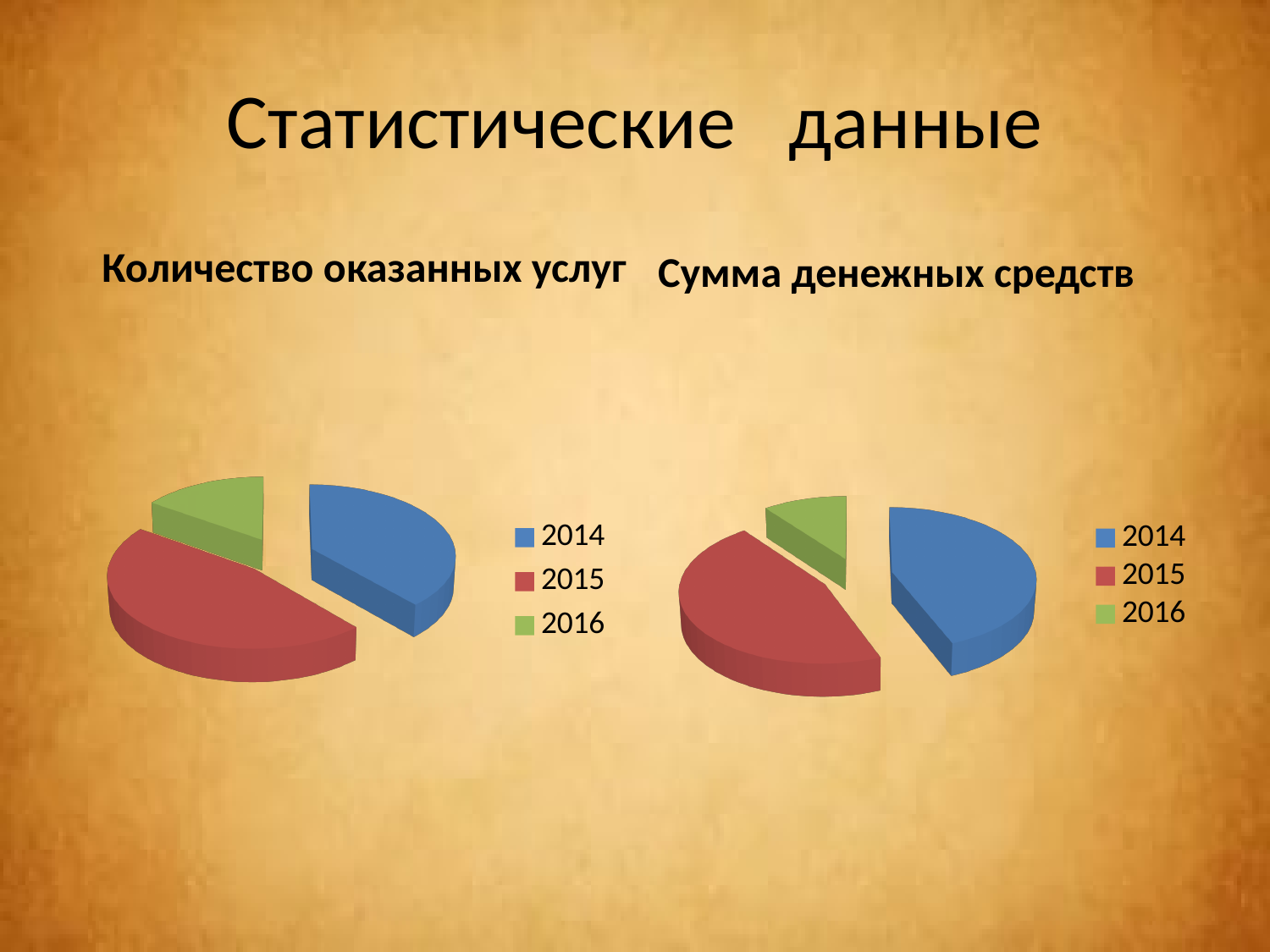
What kind of chart is the "Количество оказанных услуг" chart? pie chart What is the title of the chart on the left of the slide? Количество оказанных услуг In the "Сумма денежных средств" chart, which year has the largest slice? 2015 In the "Количество оказанных услуг" chart, which slice is larger, 2015 or 2016? 2015 In the "Сумма денежных средств" chart, which slice is larger, 2014 or 2016? 2014 In the "Количество оказанных услуг" chart, which year has the largest slice? 2015 In the "Количество оказанных услуг" chart, which year has the smallest slice? 2016 In the "Количество оказанных услуг" chart, how many slices does the pie have? 3 In the "Сумма денежных средств" chart, what colour represents 2015 in the legend? red In the "Сумма денежных средств" chart, how many entries does the legend list? 3 In the "Сумма денежных средств" chart, which year has the smallest slice? 2016 What kind of chart is the "Сумма денежных средств" chart? pie chart